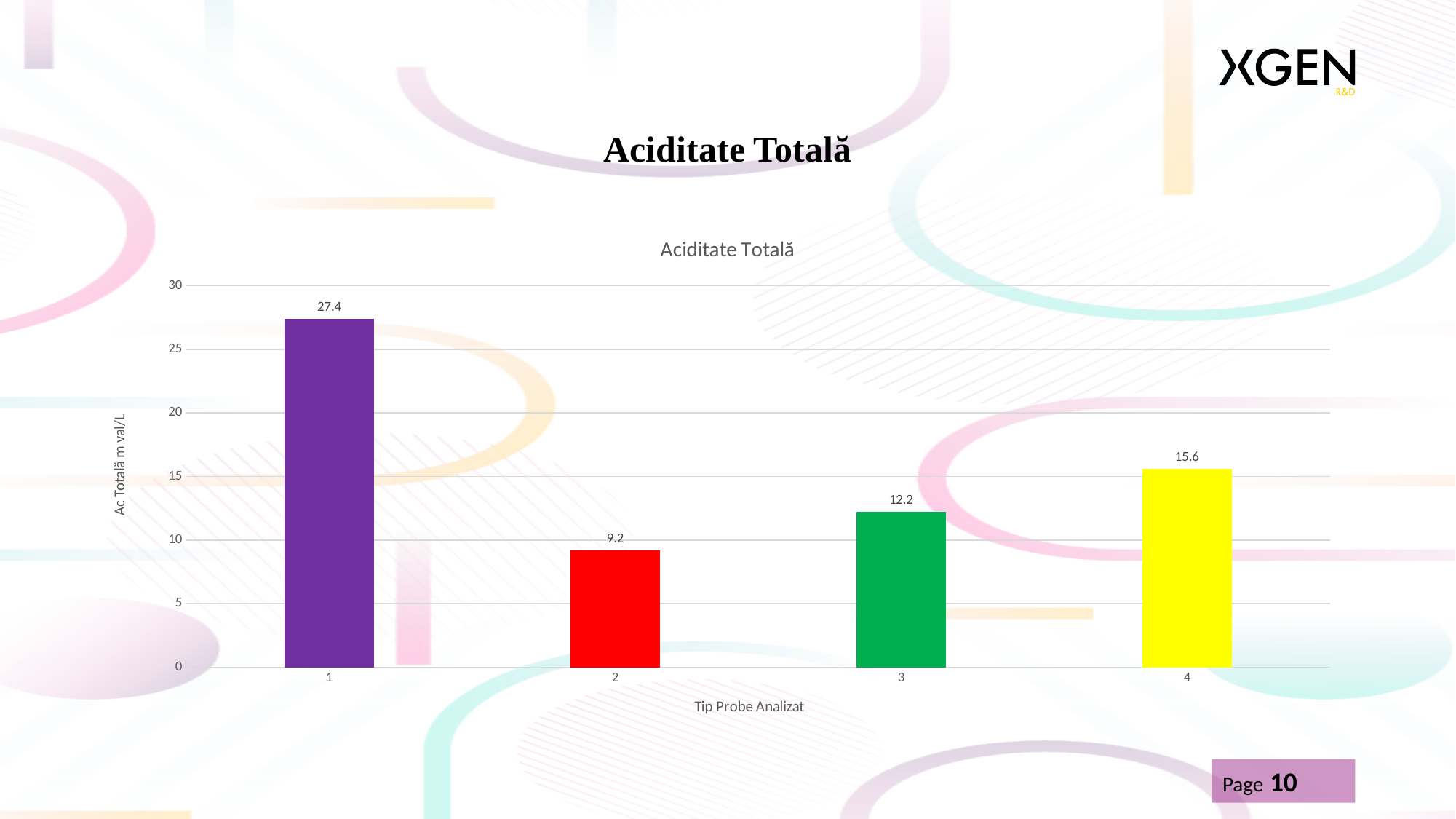
What is the value for category 3? 12.2 What is the value for category 4? 15.6 What is the difference between the values for category 1 and category 4? 11.8 Which category has the lowest value? 2 What is the value for category 2? 9.2 What is the label of the y axis? Ac Totală m val/L How many categories are shown on the x axis? 4 What is the value for category 1? 27.4 Is the value for category 2 greater or less than 10? less Which is larger, the value for category 3 or category 4? 4 What kind of chart is shown? bar chart Which category has the highest value? 1